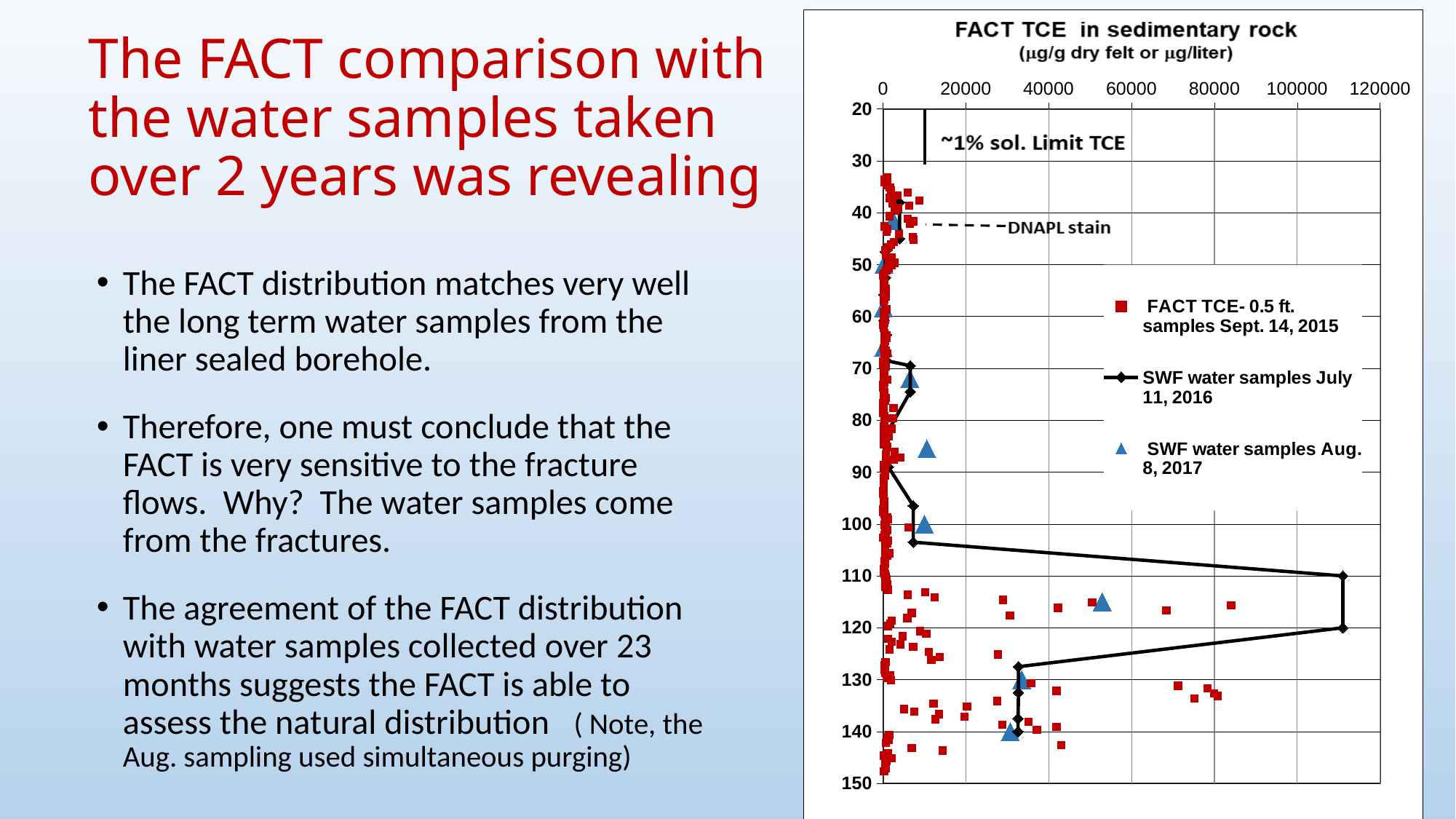
Is the SWF water samples July 11, 2016 value at depth 110 greater or less than 100000? greater Is the SWF water samples July 11, 2016 value at depth 70 greater or less than 20000? less Is the SWF water samples July 11, 2016 value at depth 120 greater or less than 100000? greater What is the title of the chart? FACT TCE in sedimentary rock Which series reaches the highest TCE value on the chart? SWF water samples July 11, 2016 Which is larger: the SWF water samples July 11, 2016 value at depth 110 or the SWF water samples Aug. 8, 2017 value near depth 115? SWF water samples July 11, 2016 value at depth 110 How many series does the chart legend list? 3 What type of chart is shown on the slide? scatter chart Which series is plotted with a black line and diamond markers? SWF water samples July 11, 2016